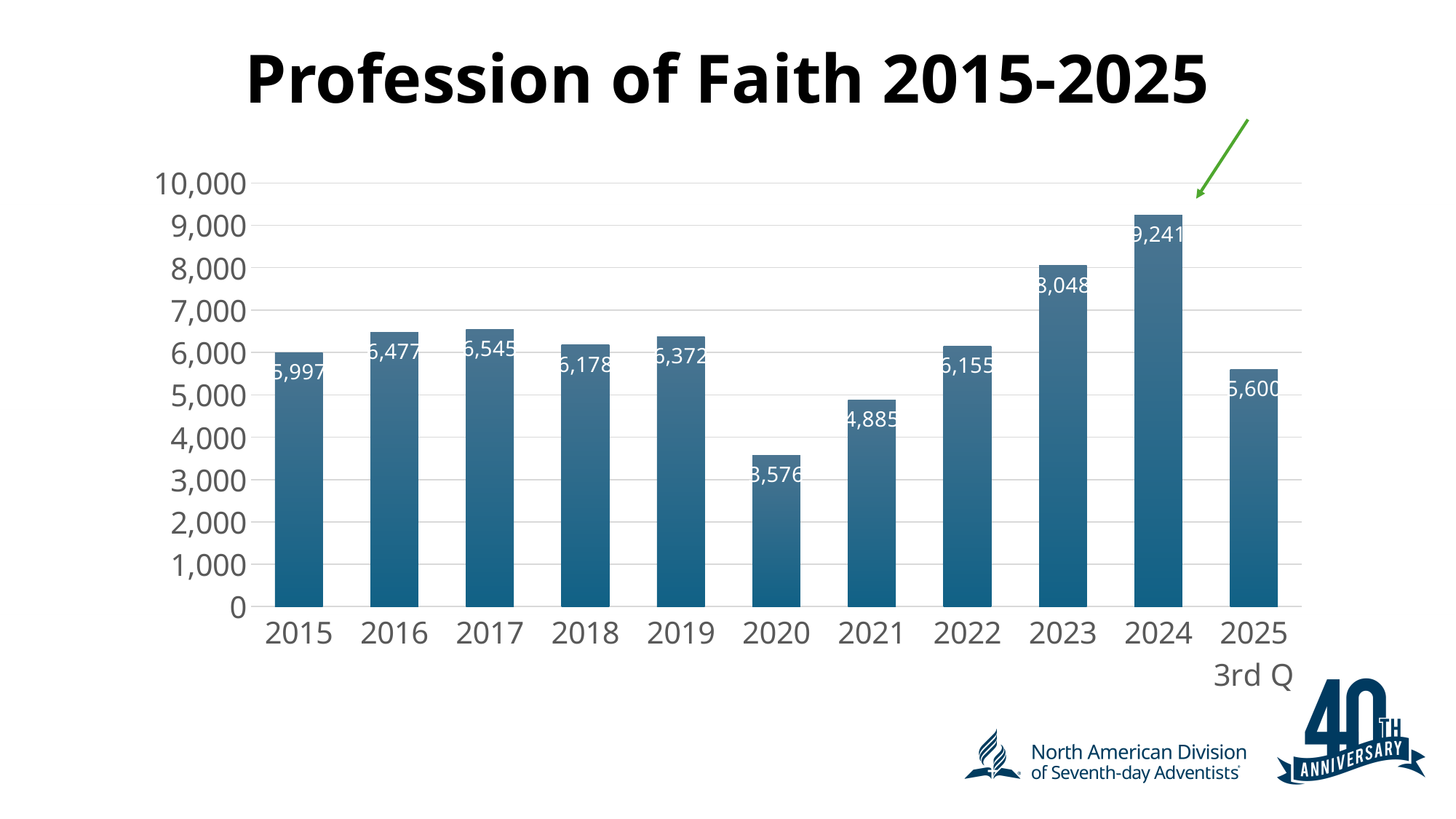
How many bars are shown in the chart? 11 What is the value for 2017? 6,545 Which is larger, the value for 2016 or the value for 2018? 2016 Is the value for 2021 greater or less than 5,000? less What is the value for 2020? 3,576 What is the difference between the values for 2024 and 2023? 1,193 What is the title of the chart? Profession of Faith 2015-2025 What kind of chart is shown on the slide? bar chart What is the value for 2025 3rd Q? 5,600 Which year has the lowest value? 2020 Which year has the highest value? 2024 What is the value for 2024? 9,241